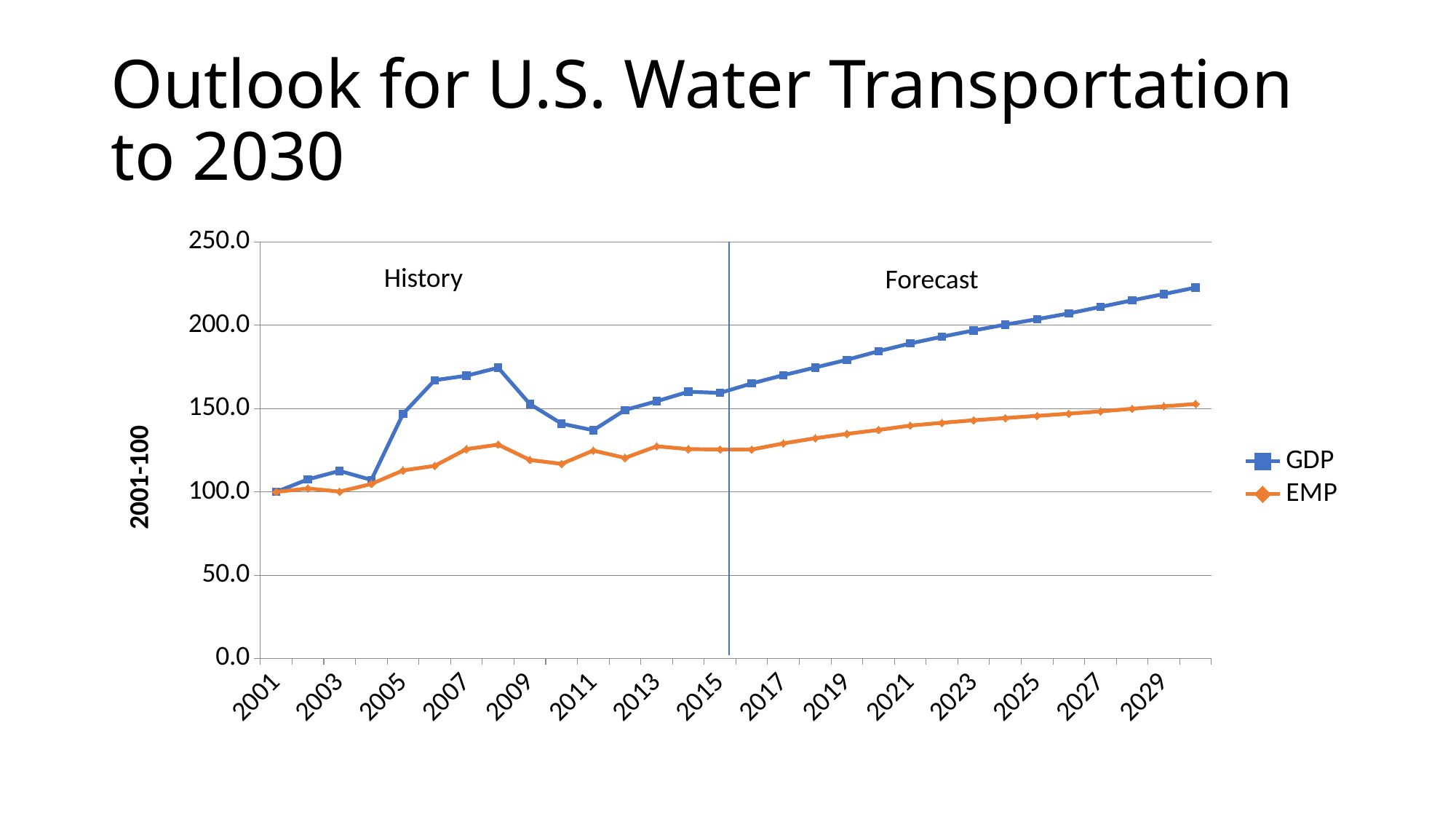
What kind of chart is shown on the slide? line chart Is the value for GDP in 2011 greater or less than 150? less Is the value for GDP in 2007 greater or less than 150? greater What is the value of GDP in 2001? 100.0 Is the value for GDP in 2029 greater or less than 200? greater How many series does the legend list? 2 What two labels divide the chart into periods on either side of the vertical line? History and Forecast Which series has the larger value in 2029, GDP or EMP? GDP Which series is higher in 2025, GDP or EMP? GDP What are the two series named in the legend? GDP and EMP Does the GDP series rise or fall across the Forecast period from 2017 to 2029? rise